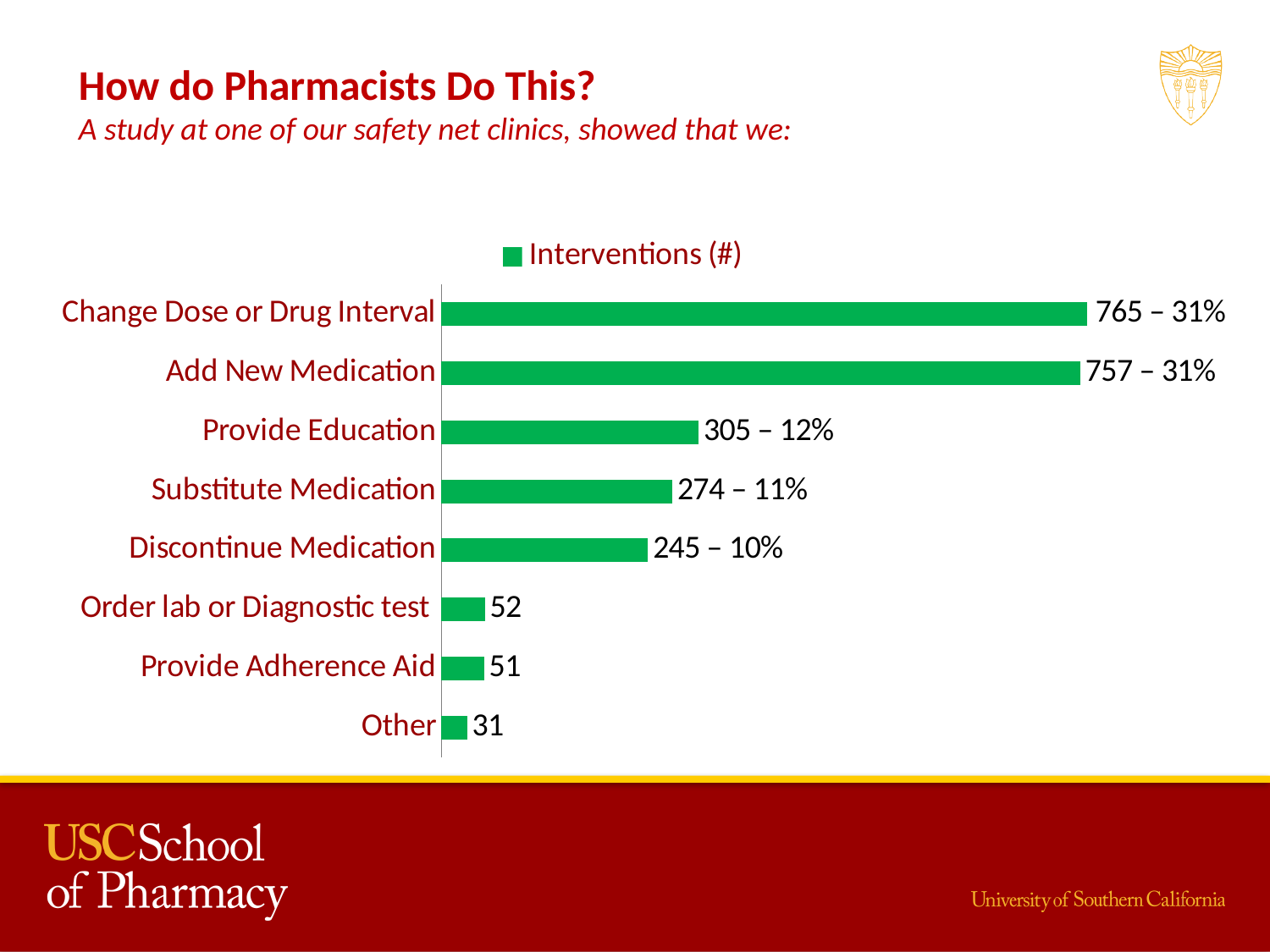
Which category has the highest number of interventions? Change Dose or Drug Interval How many categories does the chart show? 8 What is the number of interventions for Substitute Medication? 274 What percentage is shown for Add New Medication? 31% Which category has the lowest number of interventions? Other What is the legend entry for the series in the chart? Interventions (#) What is the data label for Provide Education? 305 – 12% How many series does the legend list? 1 What kind of chart is shown on the slide? bar chart Which has more interventions, Substitute Medication or Discontinue Medication? Substitute Medication What is the difference in interventions between Provide Education and Discontinue Medication? 60 What is the number of interventions for Other? 31